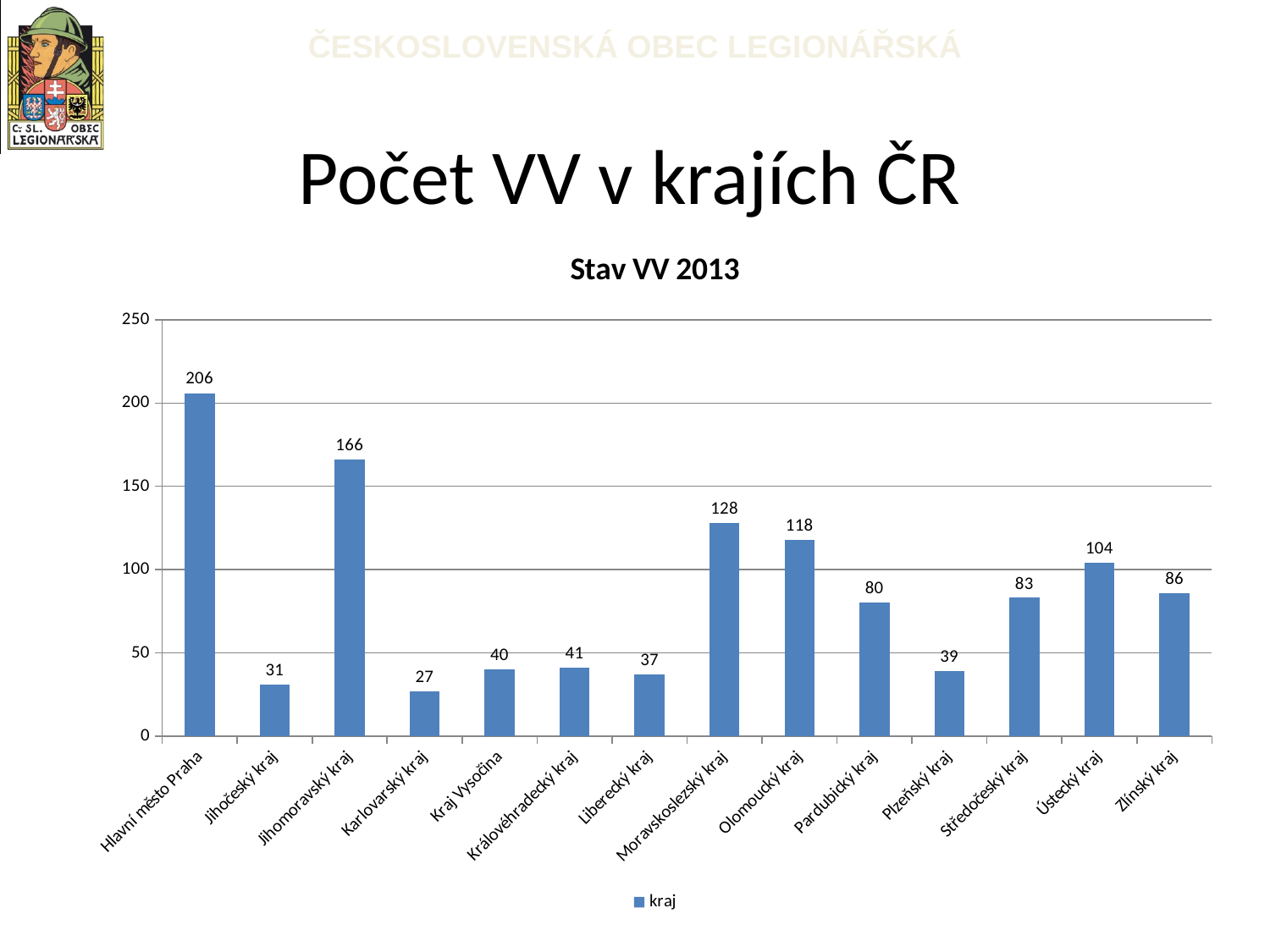
What kind of chart is shown? bar chart How many series does the legend list? 1 What is the difference between the values for Hlavní město Praha and Jihomoravský kraj? 40 What is the value for Moravskoslezský kraj? 128 Is the value for Olomoucký kraj greater or less than 100? greater What is the value for Hlavní město Praha? 206 Which category has the lowest value? Karlovarský kraj What is the value for Karlovarský kraj? 27 How many categories are shown on the x axis? 14 What is the title of the chart? Stav VV 2013 Which is larger, the value for Ústecký kraj or the value for Zlínský kraj? Ústecký kraj Which category has the highest value? Hlavní město Praha